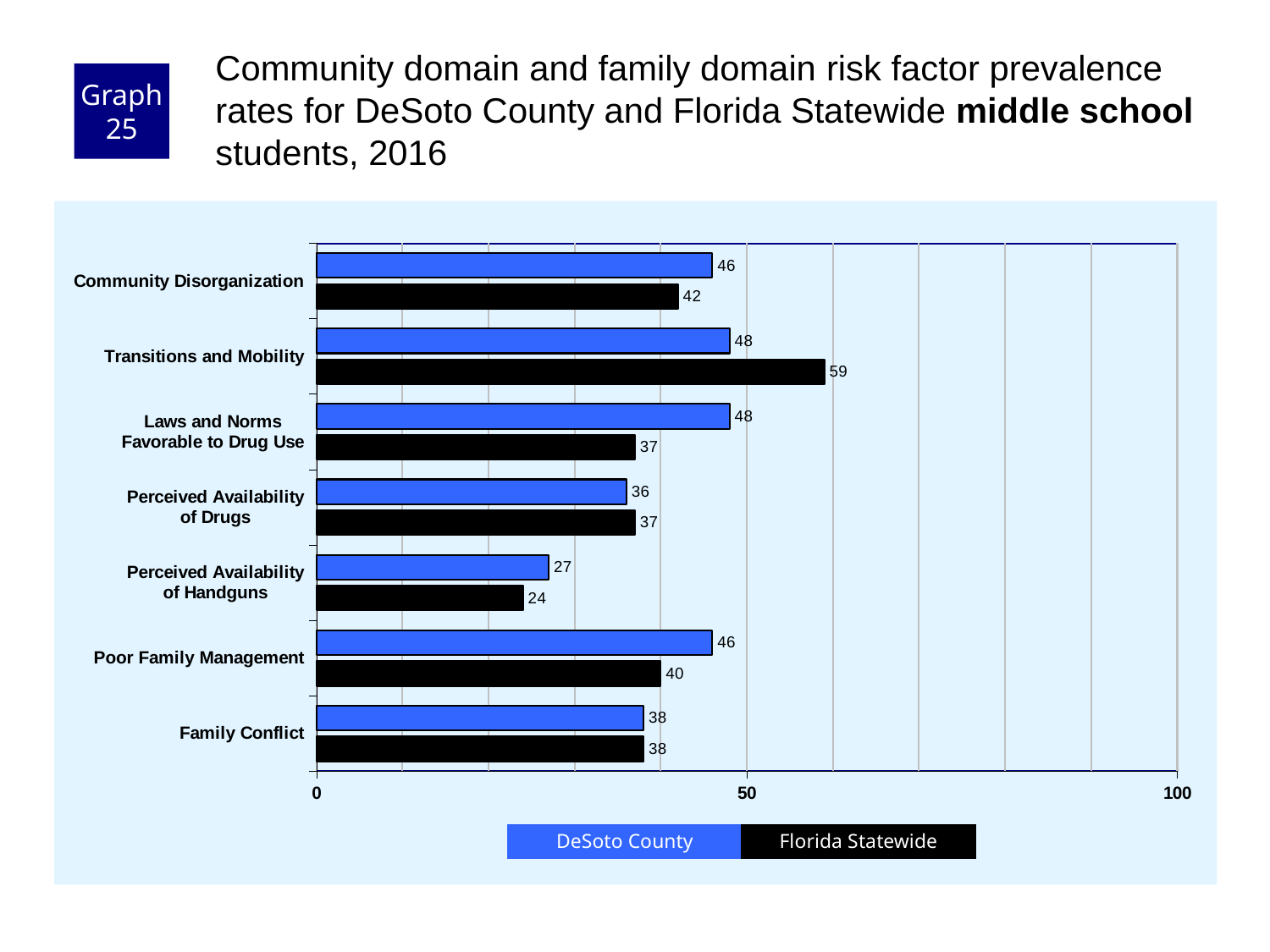
What is the difference between the DeSoto County and Florida Statewide values for Laws and Norms Favorable to Drug Use? 11 Which risk factor has the lowest DeSoto County value? Perceived Availability of Handguns Which is larger for Poor Family Management: the DeSoto County value or the Florida Statewide value? DeSoto County Which risk factor has the highest Florida Statewide value? Transitions and Mobility What is the Florida Statewide value for Transitions and Mobility? 59 What is the DeSoto County value for Community Disorganization? 46 How many series does the legend list? 2 What is the Florida Statewide value for Perceived Availability of Handguns? 24 Is the Florida Statewide value for Transitions and Mobility greater or less than 50? greater What kind of chart is shown on the slide? bar chart How many risk factor categories are shown on the chart? 7 Which colour represents Florida Statewide in the chart? black